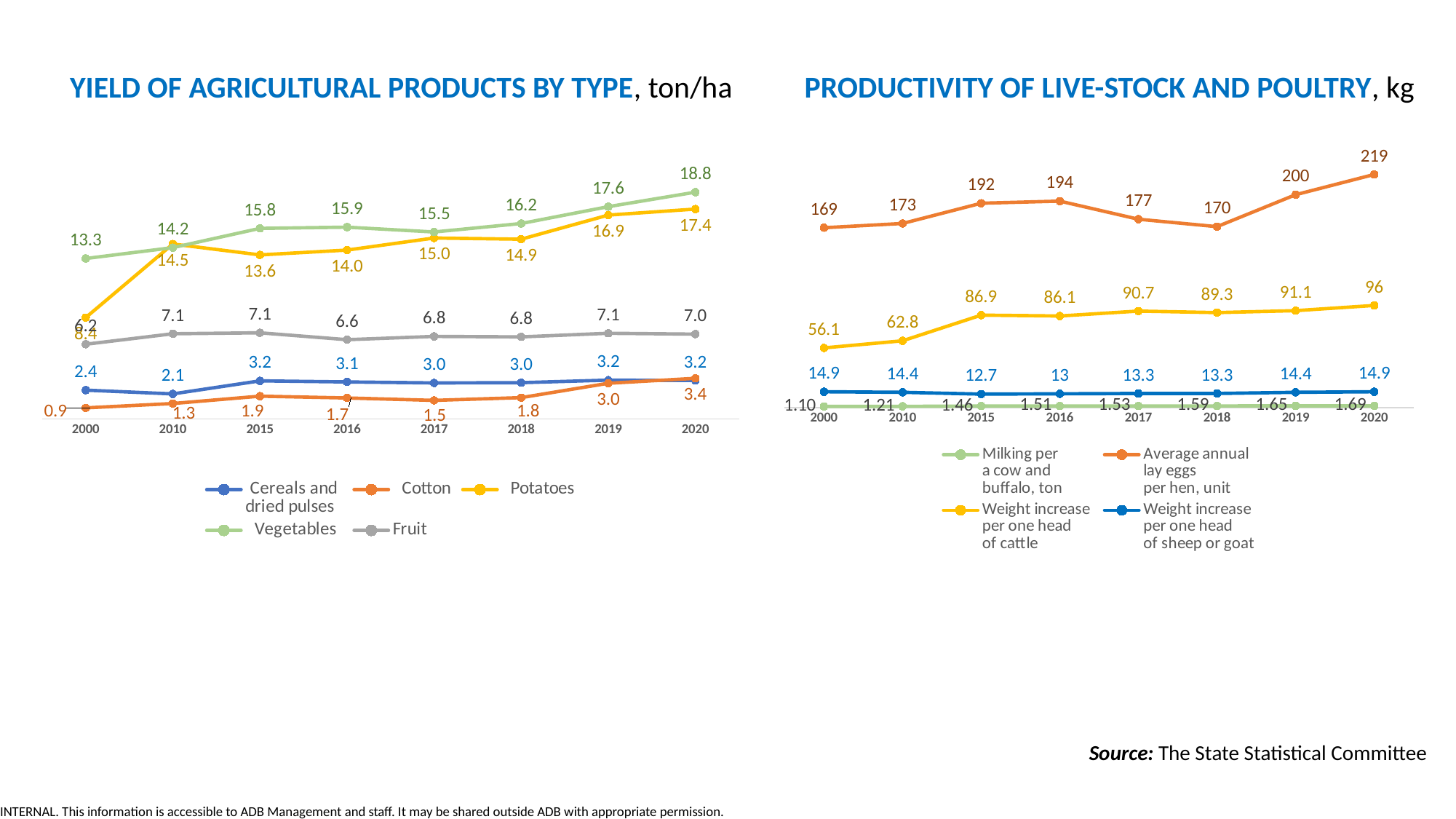
In the 'Productivity of live-stock and poultry' chart, what is the difference between the weight increase per one head of cattle in 2020 and in 2000? 39.9 In the 'Productivity of live-stock and poultry' chart, what is the average annual lay eggs per hen in 2020? 219 What kind of chart is the 'Productivity of live-stock and poultry' chart? Line chart In the 'Productivity of live-stock and poultry' chart, does milking per a cow and buffalo rise or fall from 2000 to 2020? Rise In the 'Yield of agricultural products by type' chart, which year has the highest Potatoes yield? 2020 In the 'Productivity of live-stock and poultry' chart, how many years are plotted on the x axis? 8 In the 'Yield of agricultural products by type' chart, what is the difference between the Vegetables yield in 2020 and in 2000? 5.5 In the 'Yield of agricultural products by type' chart, which is larger in 2019: the Cereals and dried pulses yield or the Cotton yield? Cereals and dried pulses In the 'Productivity of live-stock and poultry' chart, in which year is the weight increase per one head of cattle lowest? 2000 In the 'Yield of agricultural products by type' chart, how many series does the legend list? 5 In the 'Yield of agricultural products by type' chart, what is the yield of Vegetables in 2020? 18.8 In the 'Yield of agricultural products by type' chart, what is the yield of Cotton in 2000? 0.9